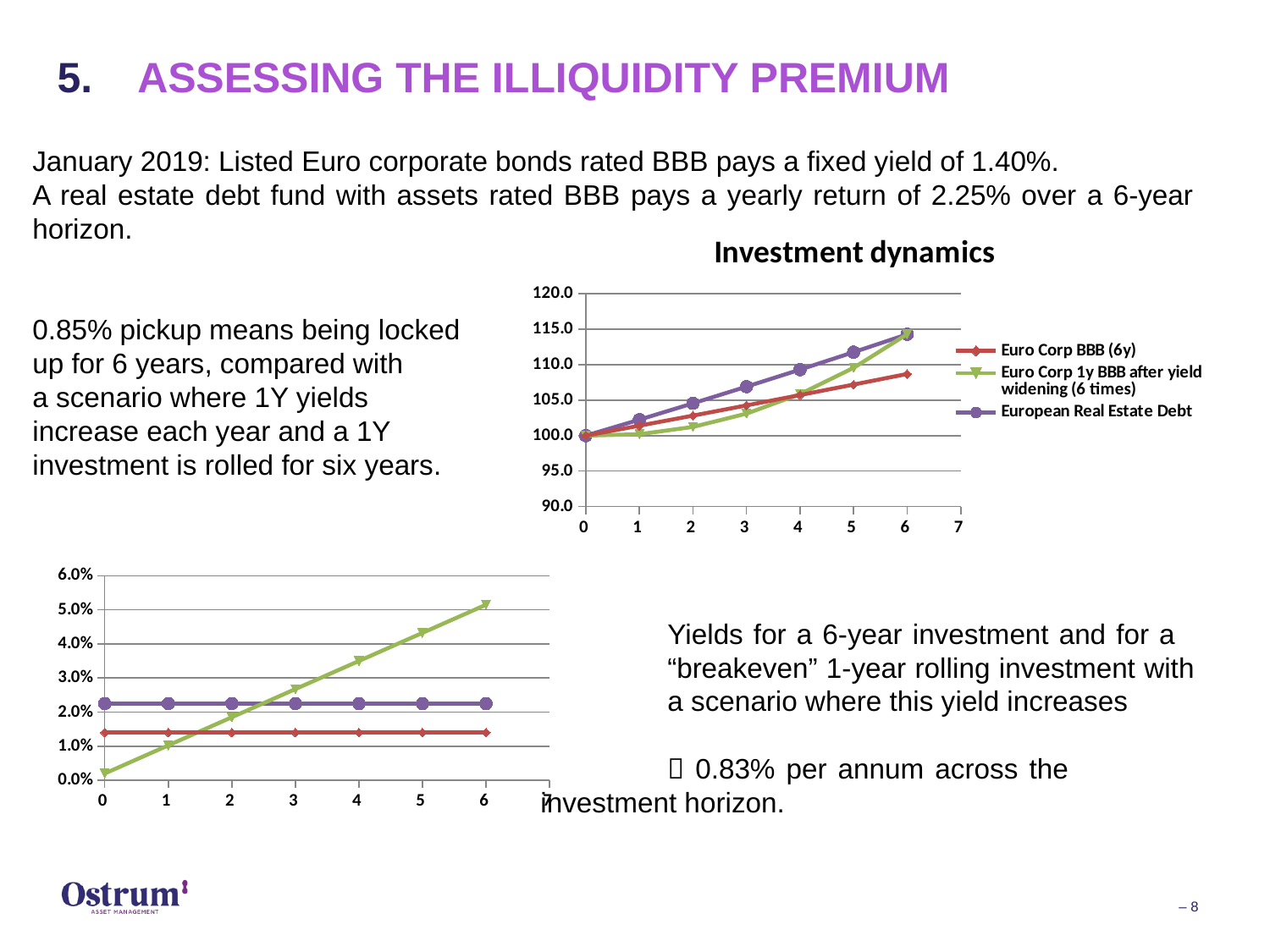
In the "Investment dynamics" chart, which series has the highest value at year 4? European Real Estate Debt In the "Investment dynamics" chart, is the value of Euro Corp BBB (6y) at year 6 greater or less than 110.0? less What type of chart is the "Investment dynamics" chart? line chart In the bottom-left chart, which line is higher at year 6, the green line or the purple line? green line In the "Investment dynamics" chart, is the value of European Real Estate Debt at year 6 greater or less than 110.0? greater In the bottom-left chart, is the value of the red line greater or less than 2.0%? less In the "Investment dynamics" chart, what is the value of all three series at year 0? 100.0 In the "Investment dynamics" chart, which series has the lowest value at year 6? Euro Corp BBB (6y) In the "Investment dynamics" chart, do the values of European Real Estate Debt rise or fall from year 0 to year 6? rise How many series does the legend of the "Investment dynamics" chart list? 3